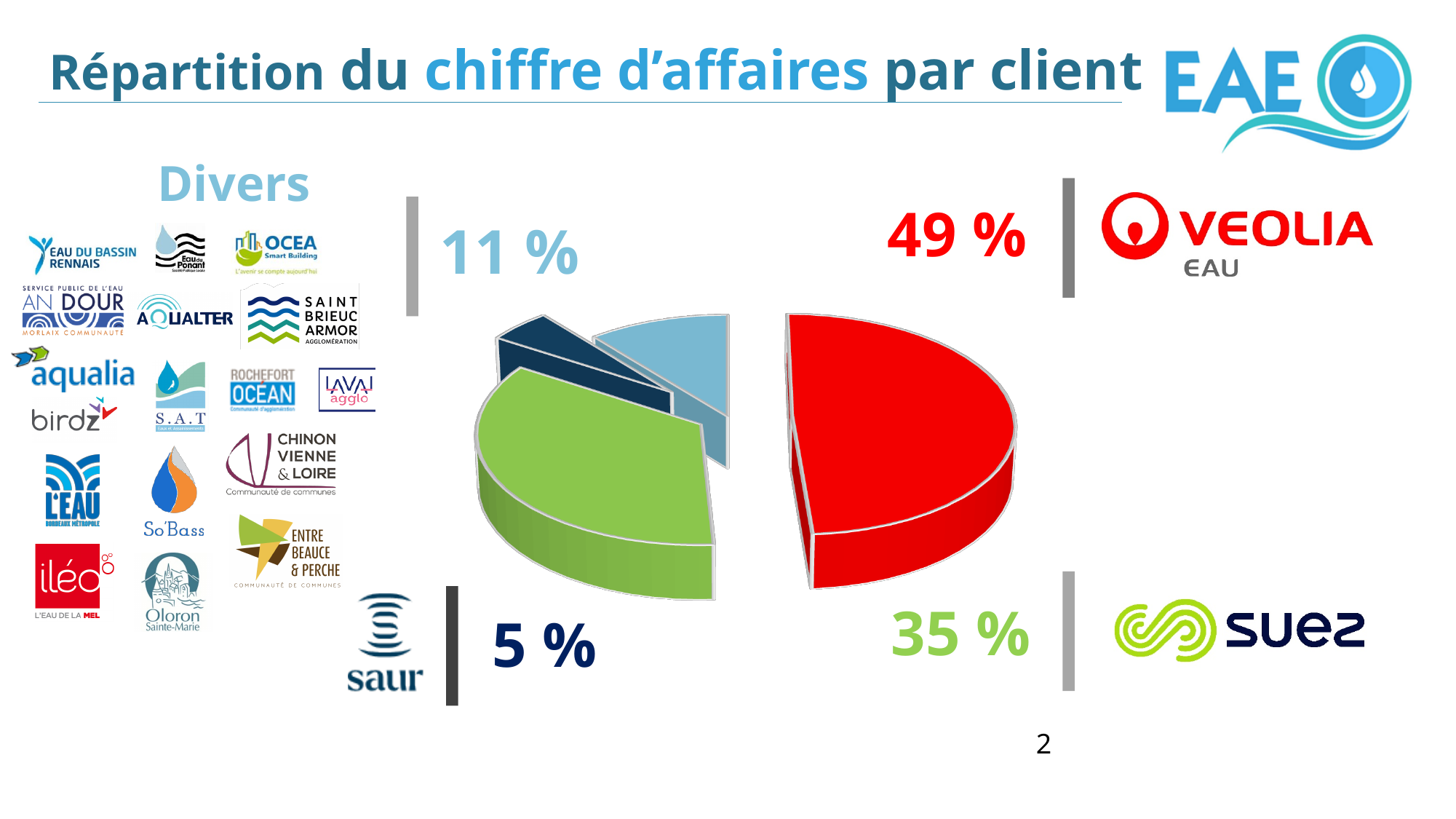
What share of revenue comes from the 'Divers' (miscellaneous) clients? 11 % What is the difference in percentage points between the Veolia share and the Suez share? 14 % What is the combined share of Veolia and Suez? 84 % Which client accounts for the smallest share of revenue? Saur What share of revenue (chiffre d'affaires) comes from Veolia? 49 % Which is larger, the share for Divers or the share for Saur? Divers How many slices does the pie chart have? 4 What kind of chart is shown on the slide? Pie chart What share of revenue comes from Suez? 35 % What share of revenue comes from Saur? 5 % Which client accounts for the largest share of revenue? Veolia What colour is the Veolia slice of the pie chart? Red